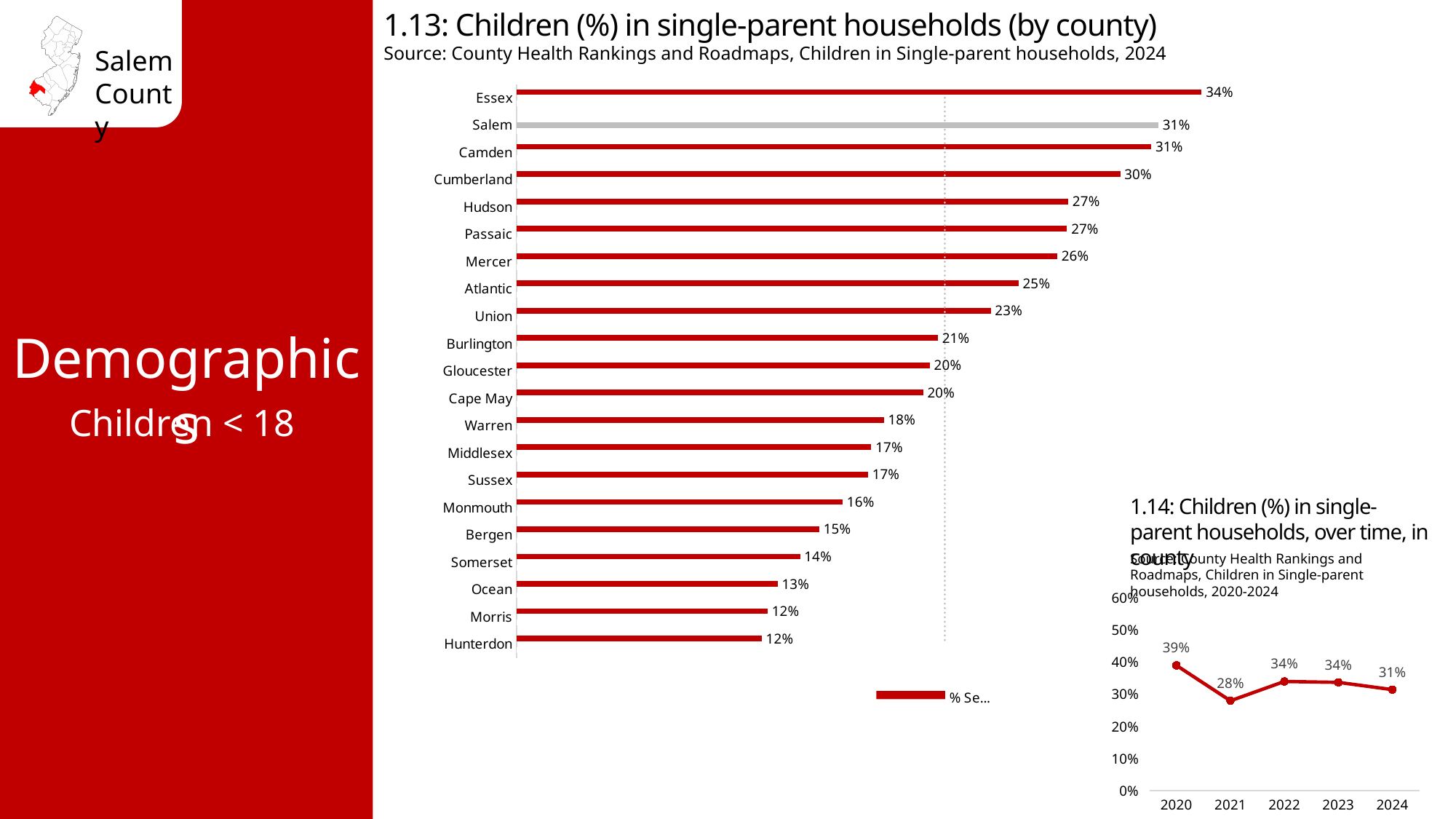
In chart 1.13 (Children (%) in single-parent households by county), what is the value for Salem? 31% In chart 1.14 (Children (%) in single-parent households over time), what is the value for 2020? 39% In chart 1.14 (over time), which year has the lowest value? 2021 In chart 1.13 (by county), which county has the highest percentage of children in single-parent households? Essex What kind of chart is chart 1.13 (Children (%) in single-parent households by county)? Bar chart In chart 1.13 (by county), which is larger, the value for Atlantic or the value for Union? Atlantic In chart 1.13 (by county), how many counties are shown? 21 In chart 1.13 (by county), what is the value for Gloucester? 20% In chart 1.13 (by county), what is the difference between Essex and Hunterdon? 22% What kind of chart is chart 1.14 (Children (%) in single-parent households over time)? Line chart In chart 1.13 (by county), what is the value for Cumberland? 30% In chart 1.14 (over time), what is the difference between the 2020 and 2024 values? 8%